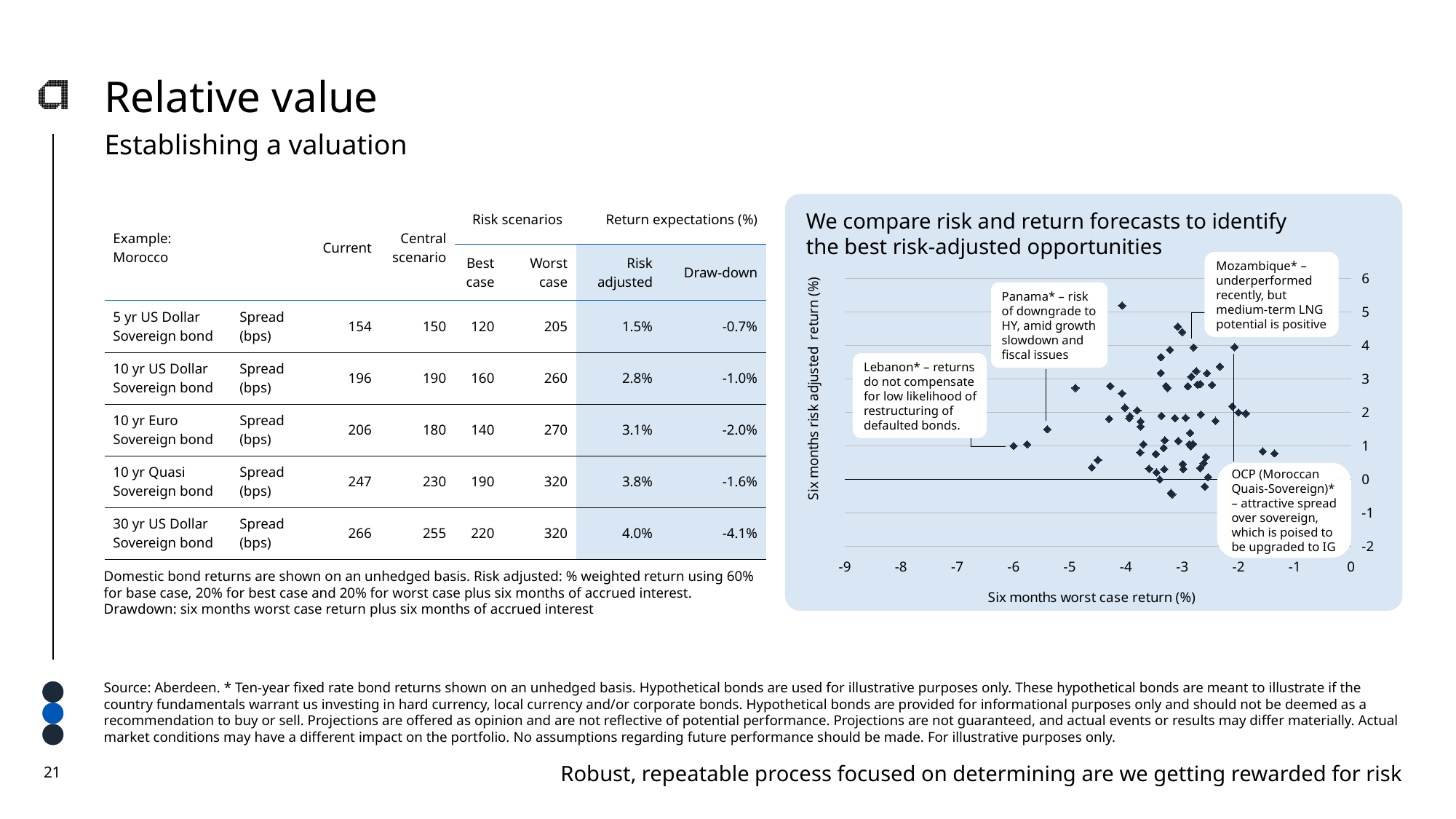
What kind of chart is shown on the right side of the slide? Scatter chart Which annotated point on the scatter chart is described as having returns that do not compensate for low likelihood of restructuring of defaulted bonds? Lebanon On the scatter chart, is the six months risk adjusted return for the Mozambique point greater or less than 3? greater What is the title of the y axis of the scatter chart? Six months risk adjusted return (%) On the scatter chart, is the lowest plotted six months risk adjusted return greater or less than 0? less What is the lowest value shown on the y axis of the scatter chart? -2 What is the title of the x axis of the scatter chart? Six months worst case return (%) How many countries or issuers are called out with annotation boxes on the scatter chart? 4 What is the highest value shown on the y axis of the scatter chart? 6 On the scatter chart, is the six months risk adjusted return for the OCP (Moroccan Quais-Sovereign) point greater or less than 2? greater What is the lowest value shown on the x axis of the scatter chart? -9